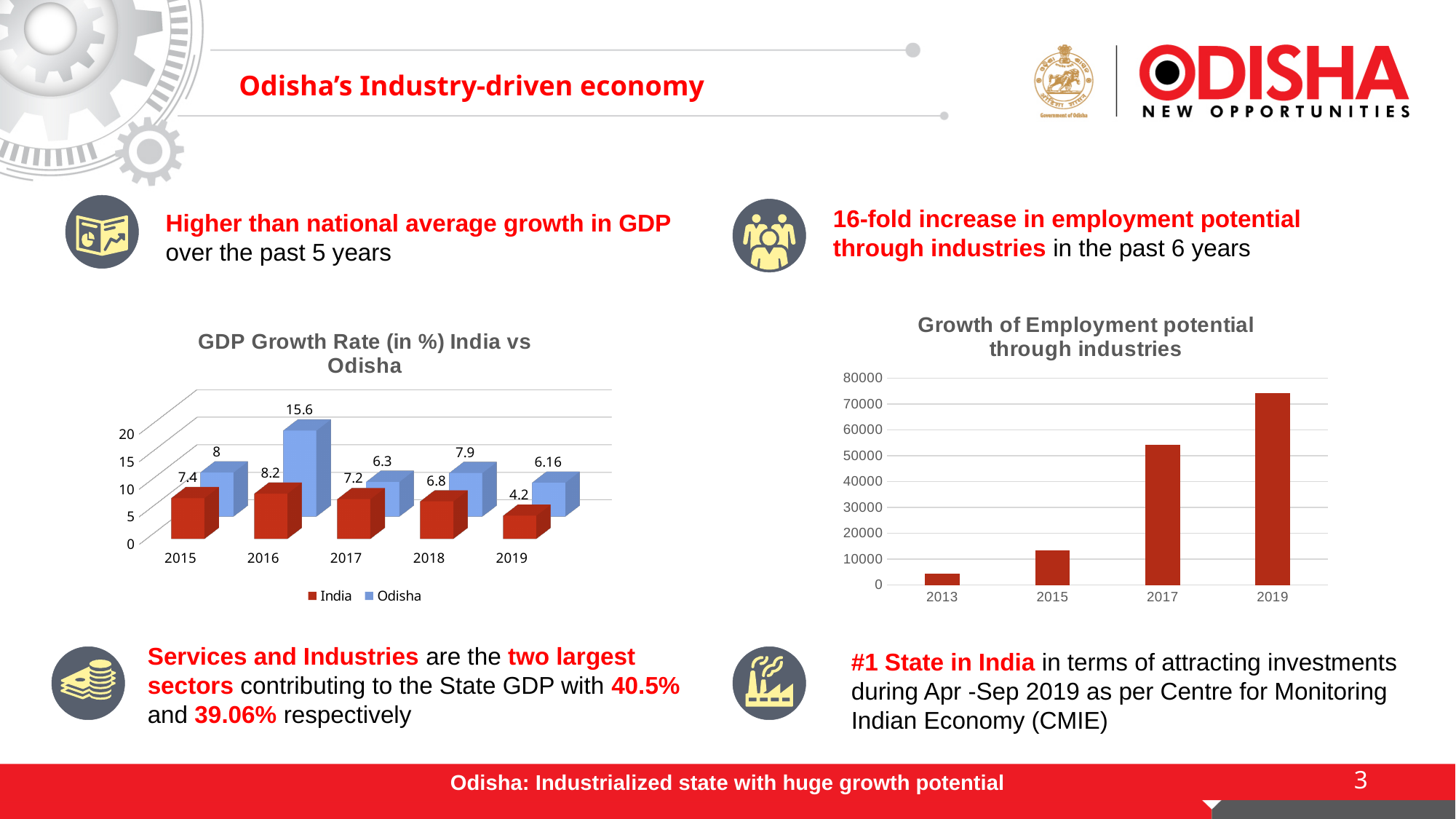
How many years are shown on the x axis of the 'Growth of Employment potential through industries' chart? 4 How many series does the legend of the 'GDP Growth Rate (in %) India vs Odisha' chart list? 2 In the 'GDP Growth Rate (in %) India vs Odisha' chart, which is larger in 2017, India or Odisha? India Do the values in the 'Growth of Employment potential through industries' chart rise or fall from 2013 to 2019? rise In the 'GDP Growth Rate (in %) India vs Odisha' chart, what is the value for Odisha in 2016? 15.6 In the 'GDP Growth Rate (in %) India vs Odisha' chart, what is the value for Odisha in 2019? 6.16 In the 'GDP Growth Rate (in %) India vs Odisha' chart, which year has the highest value for Odisha? 2016 In the 'Growth of Employment potential through industries' chart, is the value for 2019 greater or less than 70000? greater In the 'Growth of Employment potential through industries' chart, is the value for 2015 greater or less than 20000? less In the 'GDP Growth Rate (in %) India vs Odisha' chart, what is the difference between the Odisha and India values in 2016? 7.4 In the 'GDP Growth Rate (in %) India vs Odisha' chart, what is the value for India in 2019? 4.2 In the 'GDP Growth Rate (in %) India vs Odisha' chart, which year has the lowest value for India? 2019